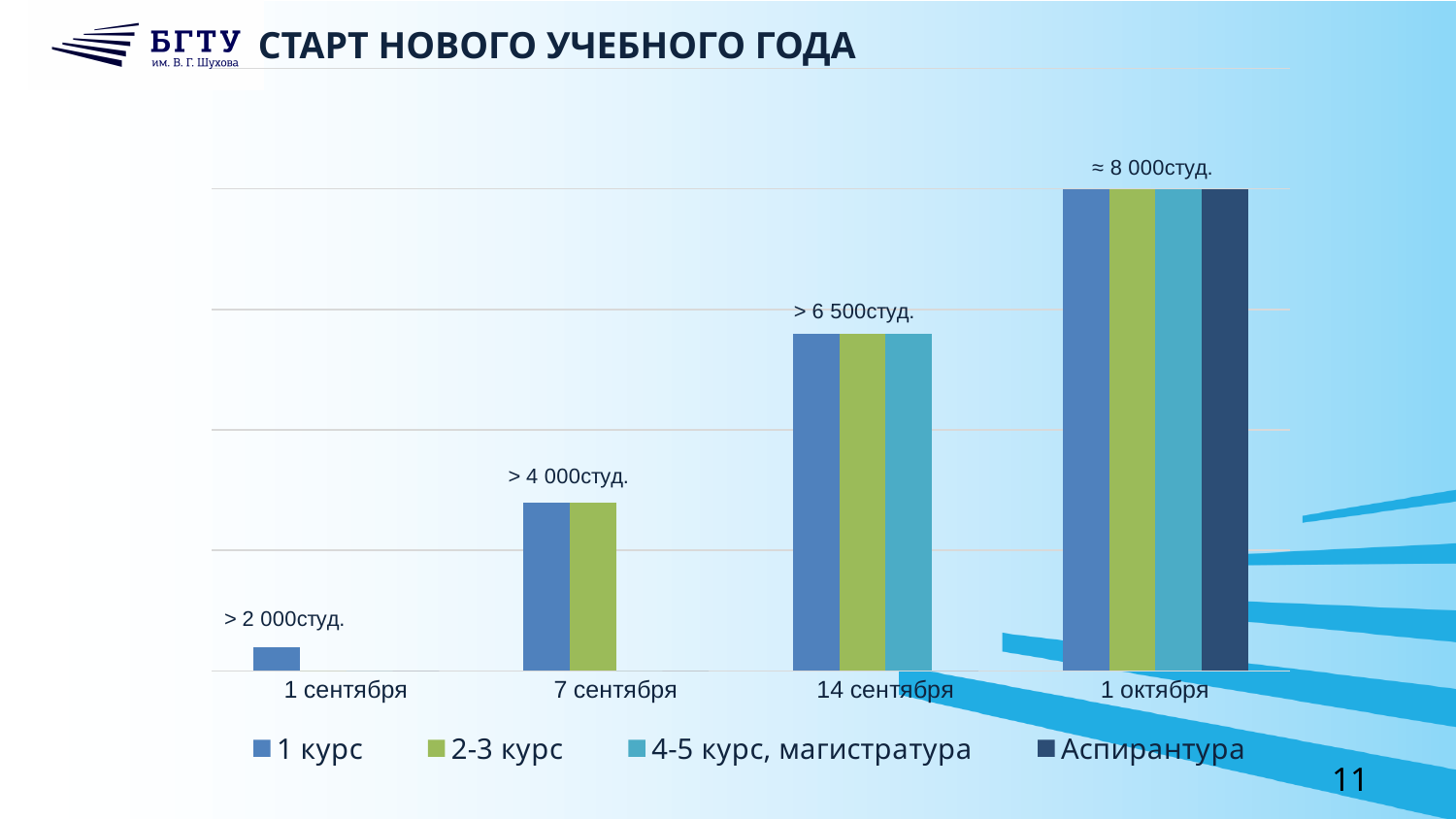
Which is taller: the bar for 7 сентября or the bar for 14 сентября? 14 сентября Which series is shown in dark navy in the chart legend? Аспирантура How many series have bars plotted for 1 октября? 4 How many series have bars plotted for 1 сентября? 1 How many series does the chart legend list? 4 How many categories (dates) are shown on the x axis of the chart? 4 What kind of chart is shown on the slide? Bar chart Do the bar heights rise or fall from 1 сентября to 1 октября? Rise Which date has the tallest bars in the chart? 1 октября Which date has the shortest bar in the chart? 1 сентября What is the title of the slide containing the chart? СТАРТ НОВОГО УЧЕБНОГО ГОДА